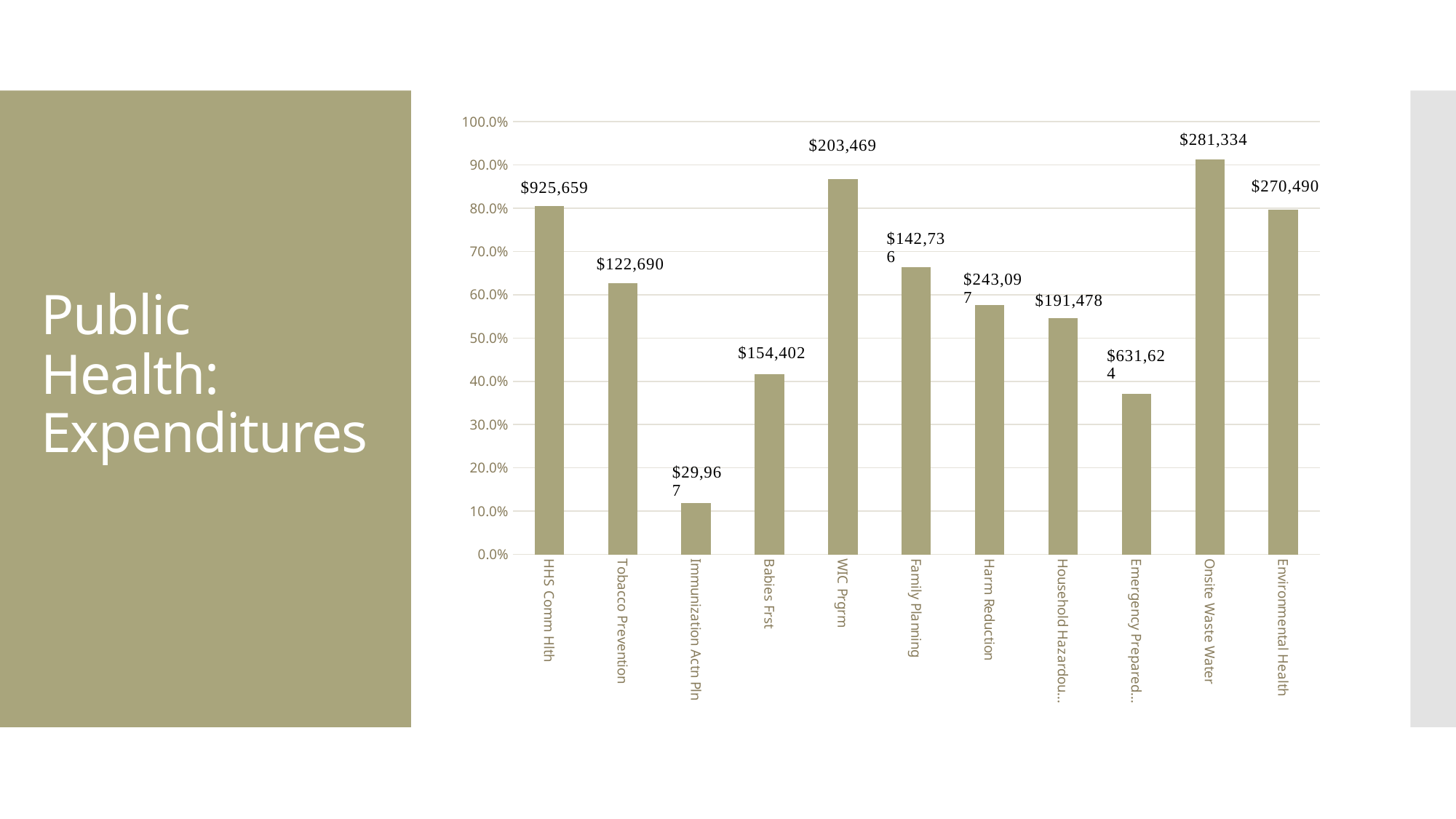
What is the data label shown above the Onsite Waste Water bar? $281,334 Which category has the tallest bar in the chart? Onsite Waste Water Is the bar for Babies Frst greater or less than 50.0%? less What is the data label shown above the Tobacco Prevention bar? $122,690 What is the data label shown above the Environmental Health bar? $270,490 Is the bar for WIC Prgrm greater or less than 80.0%? greater What is the difference between the data labels for Onsite Waste Water and Environmental Health? $10,844 What is the data label shown above the HHS Comm Hlth bar? $925,659 What is the data label shown above the WIC Prgrm bar? $203,469 How many categories are shown on the x axis of the chart? 11 What kind of chart is shown on the slide? bar chart Which category has the shortest bar in the chart? Immunization Actn Pln